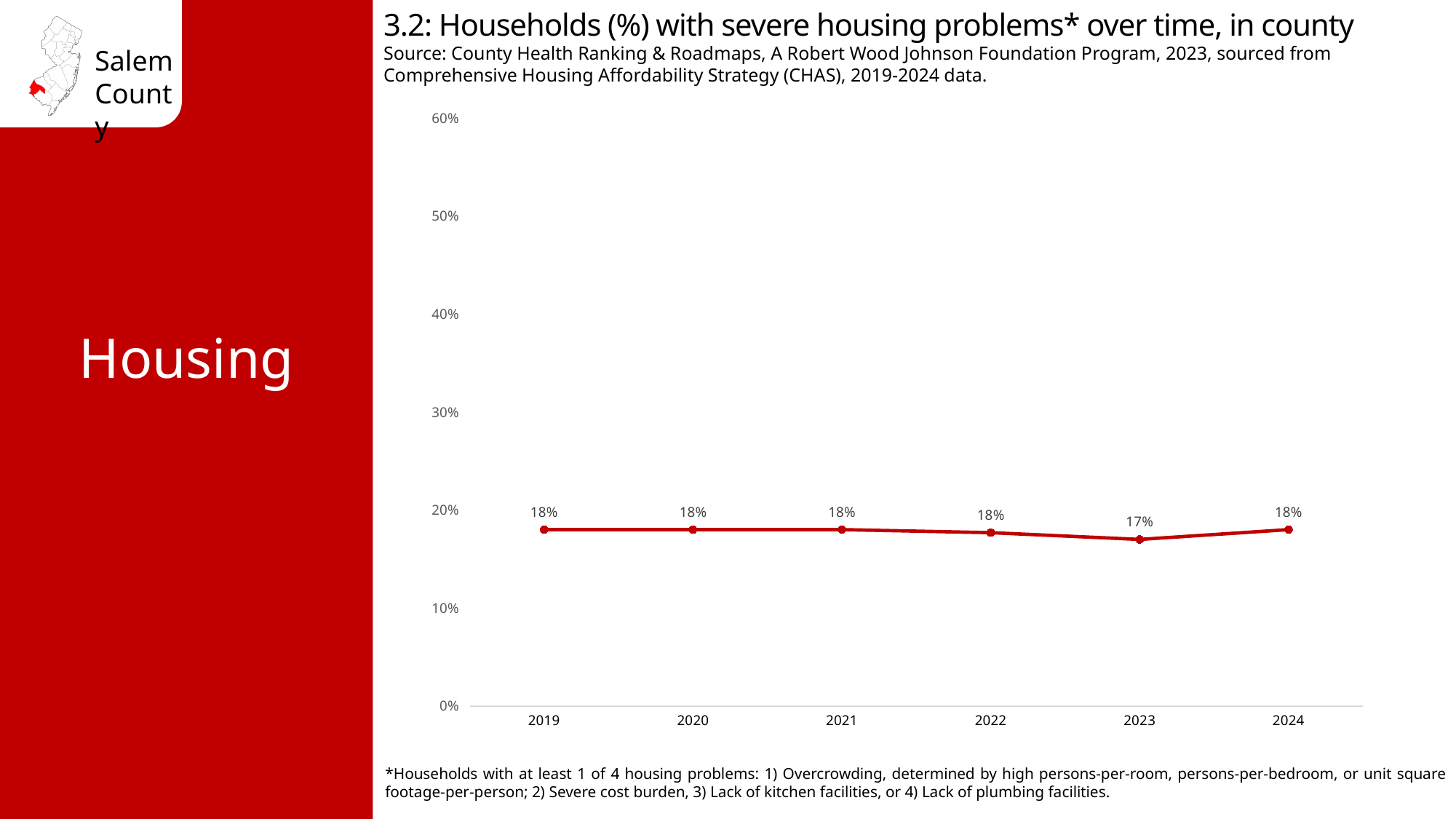
What is the difference between the values for 2022 and 2023? 1% How many years are plotted on the chart? 6 Which year has the lowest value? 2023 What is the value for 2024? 18% Is the value for 2020 greater or less than 20%? less What is the title of the chart? 3.2: Households (%) with severe housing problems* over time, in county What is the value for 2023? 17% Does the value rise or fall from 2023 to 2024? rise Is the value for 2023 greater or less than 10%? greater What is the value for 2019? 18% What is the value for 2021? 18% What kind of chart is shown on the slide? line chart